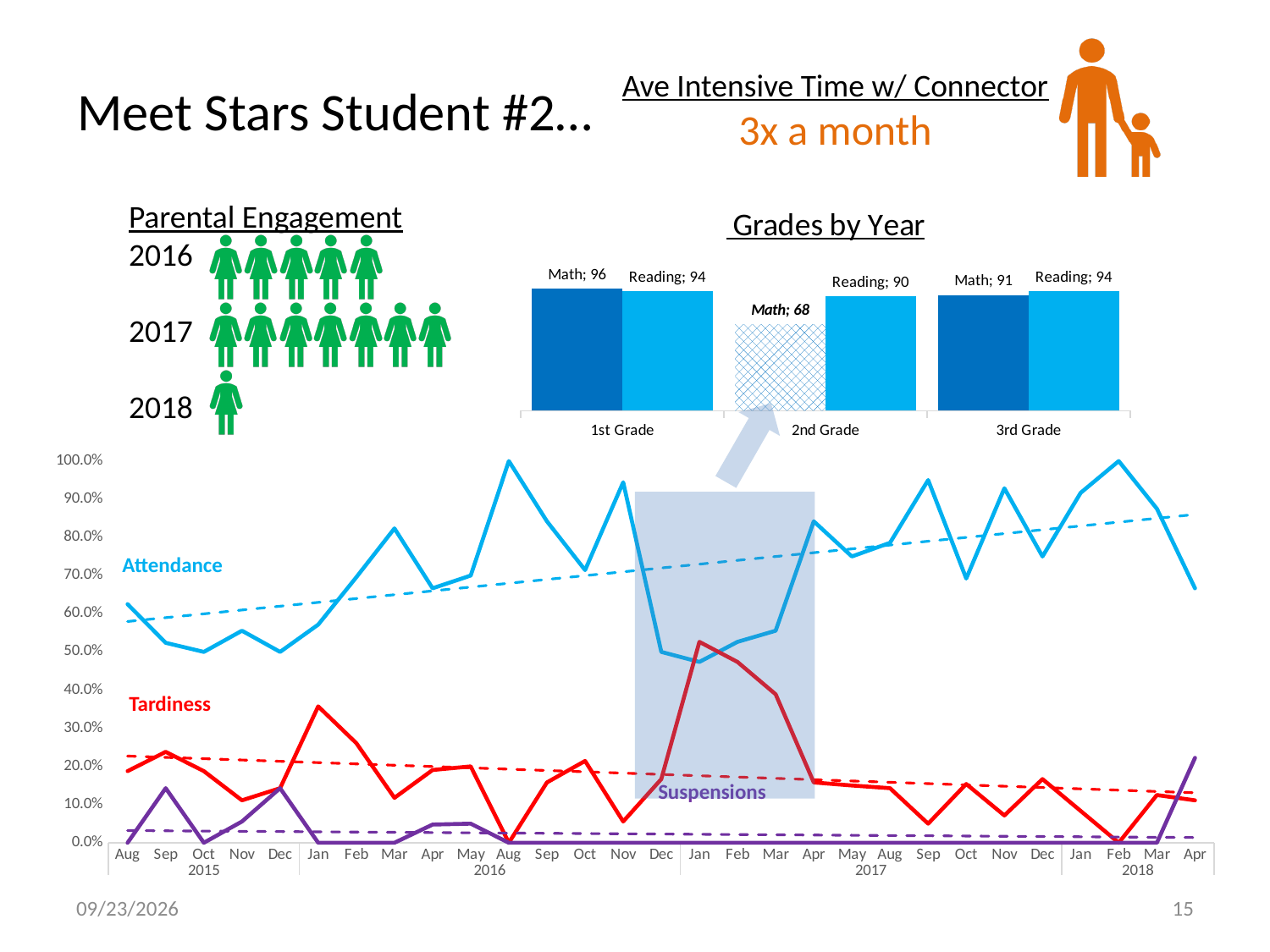
In the Grades by Year chart, which is larger for 3rd Grade, the Math score or the Reading score? Reading In the line chart at the bottom of the slide, does the dashed Attendance trend line rise or fall from left to right? Rise In the Grades by Year chart, what is the Reading score for 2nd Grade? 90 In the Grades by Year chart, what is the difference between the 1st Grade Math score and the 2nd Grade Math score? 28 In the line chart at the bottom of the slide, is the Attendance value for Oct 2015 greater or less than 60.0%? less How many data series are labelled in the line chart at the bottom of the slide? 3 In the line chart at the bottom of the slide, is the Attendance value for Aug 2016 greater or less than 90.0%? greater In the Grades by Year chart, what is the Math score for 1st Grade? 96 What kind of chart is the Grades by Year chart? Bar chart In the Grades by Year chart, how many grade levels are shown on the x axis? 3 In the line chart at the bottom of the slide, is the Tardiness value for Jan 2017 greater or less than 40.0%? greater In the Grades by Year chart, which grade has the lowest Math score? 2nd Grade